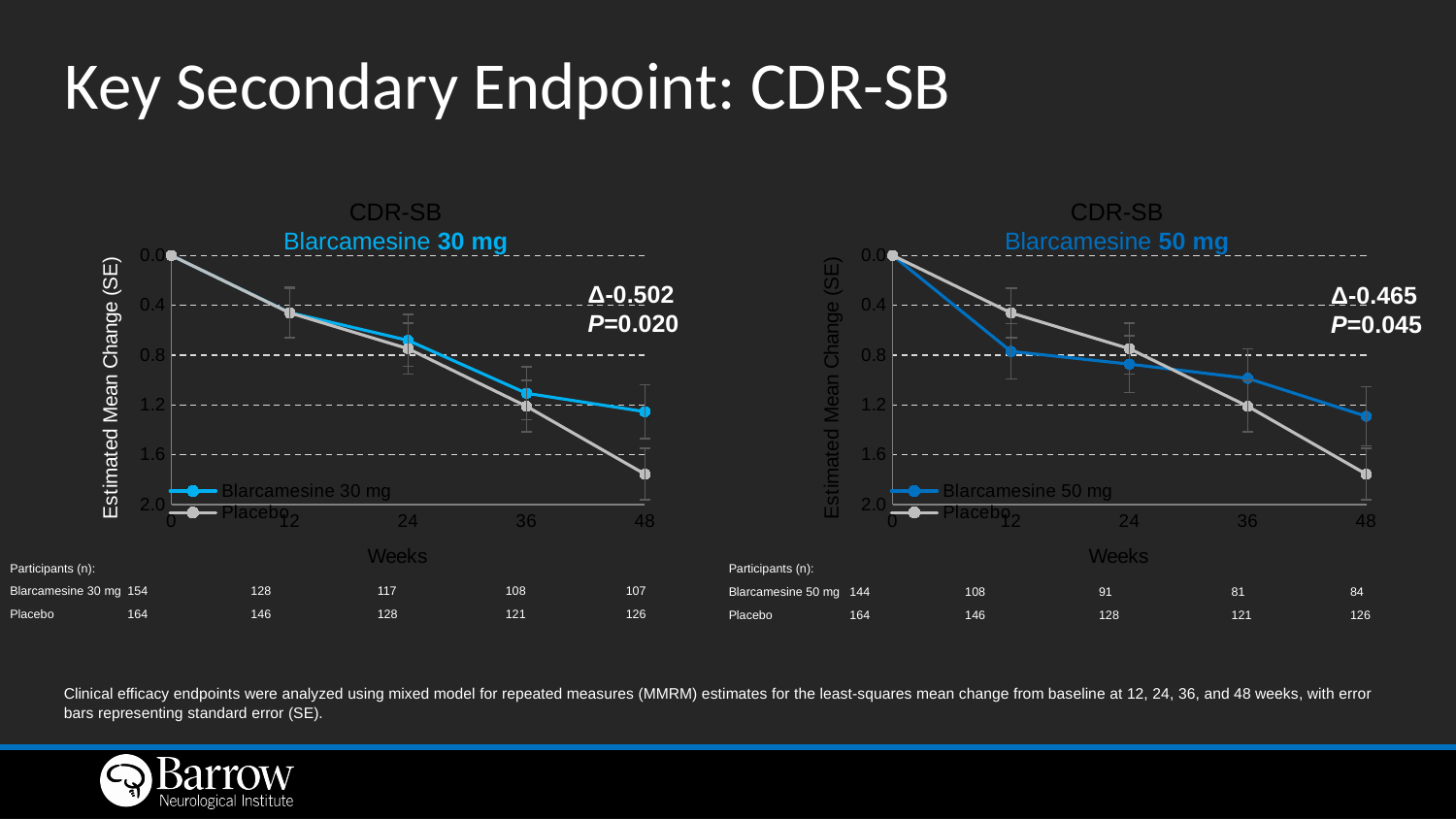
In the CDR-SB Blarcamesine 50 mg chart on the right, what P value is printed? P=0.045 In the CDR-SB Blarcamesine 30 mg chart on the left, does the Placebo estimated mean change increase or decrease from week 0 to week 48? increase In the CDR-SB Blarcamesine 50 mg chart on the right, is the Placebo value at week 48 greater or less than 1.6? greater In the CDR-SB Blarcamesine 30 mg chart on the left, what treatment difference (Δ) is printed? Δ-0.502 In the CDR-SB Blarcamesine 50 mg chart on the right, which series has the larger estimated mean change at week 12, Blarcamesine 50 mg or Placebo? Blarcamesine 50 mg In the CDR-SB Blarcamesine 30 mg chart on the left, is the Placebo value at week 48 greater or less than 1.6? greater How many week time points are plotted on the x axis of the CDR-SB Blarcamesine 30 mg chart on the left? 5 How many series does the legend of the CDR-SB Blarcamesine 50 mg chart on the right list? 2 In the CDR-SB Blarcamesine 50 mg chart on the right, is the Blarcamesine 50 mg value at week 36 greater or less than 0.8? greater In the CDR-SB Blarcamesine 30 mg chart on the left, which series has the larger estimated mean change at week 48, Blarcamesine 30 mg or Placebo? Placebo What kind of chart is the CDR-SB Blarcamesine 30 mg chart on the left? line chart